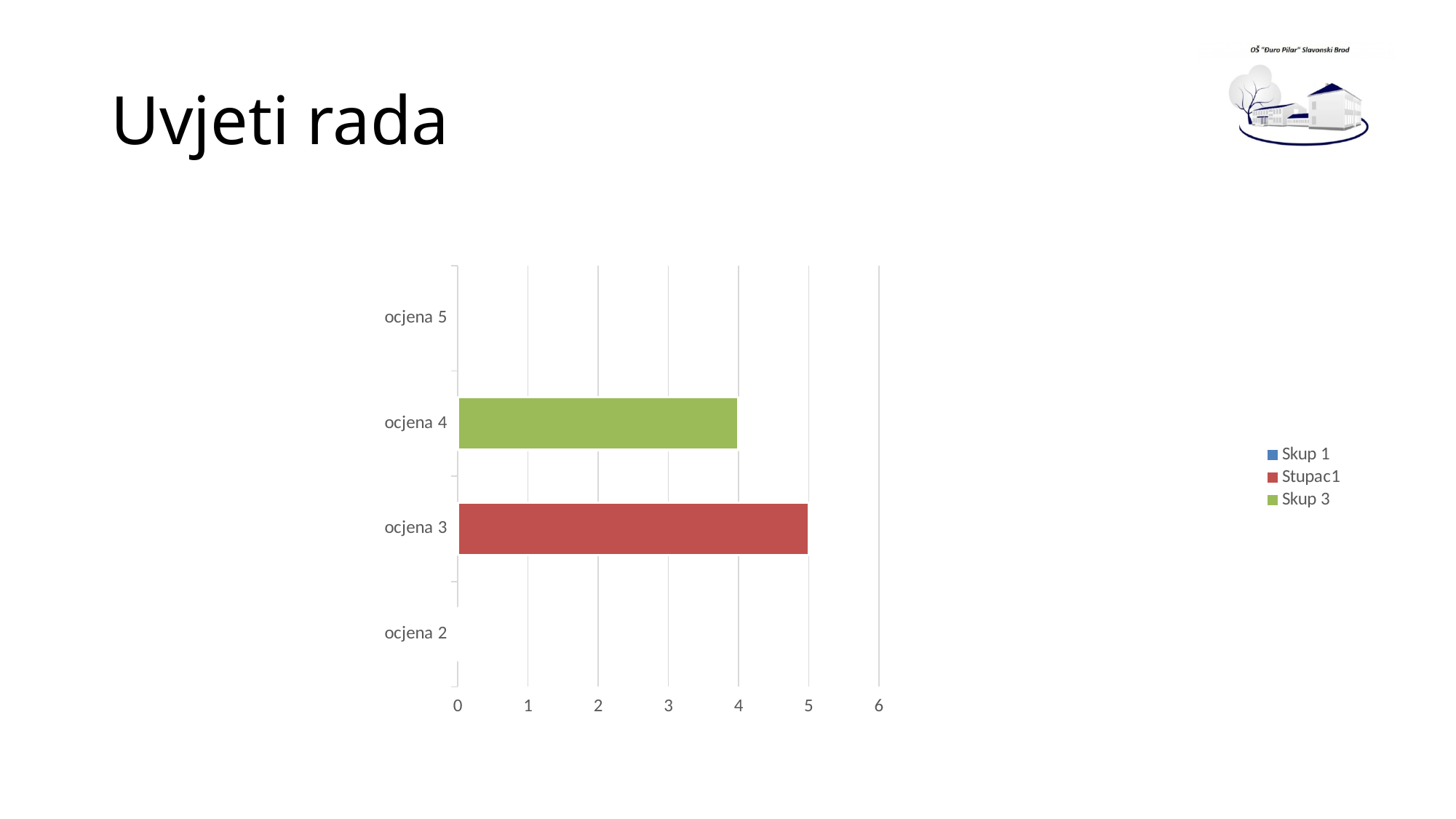
What is the difference between the bar for ocjena 3 and the bar for ocjena 4? 1 How many categories are listed on the vertical axis of the chart? 4 How many series does the chart legend list? 3 Which is larger, the bar for ocjena 3 or the bar for ocjena 4? ocjena 3 What is the title of the slide containing the chart? Uvjeti rada Which category has the longest bar? ocjena 3 Is the value for ocjena 4 greater or less than 3? greater Which legend entry is shown in green? Skup 3 Is the value for ocjena 3 greater or less than 6? less What is the value of the bar for ocjena 3? 5 What kind of chart is shown on the slide? bar chart What is the value of the bar for ocjena 4? 4